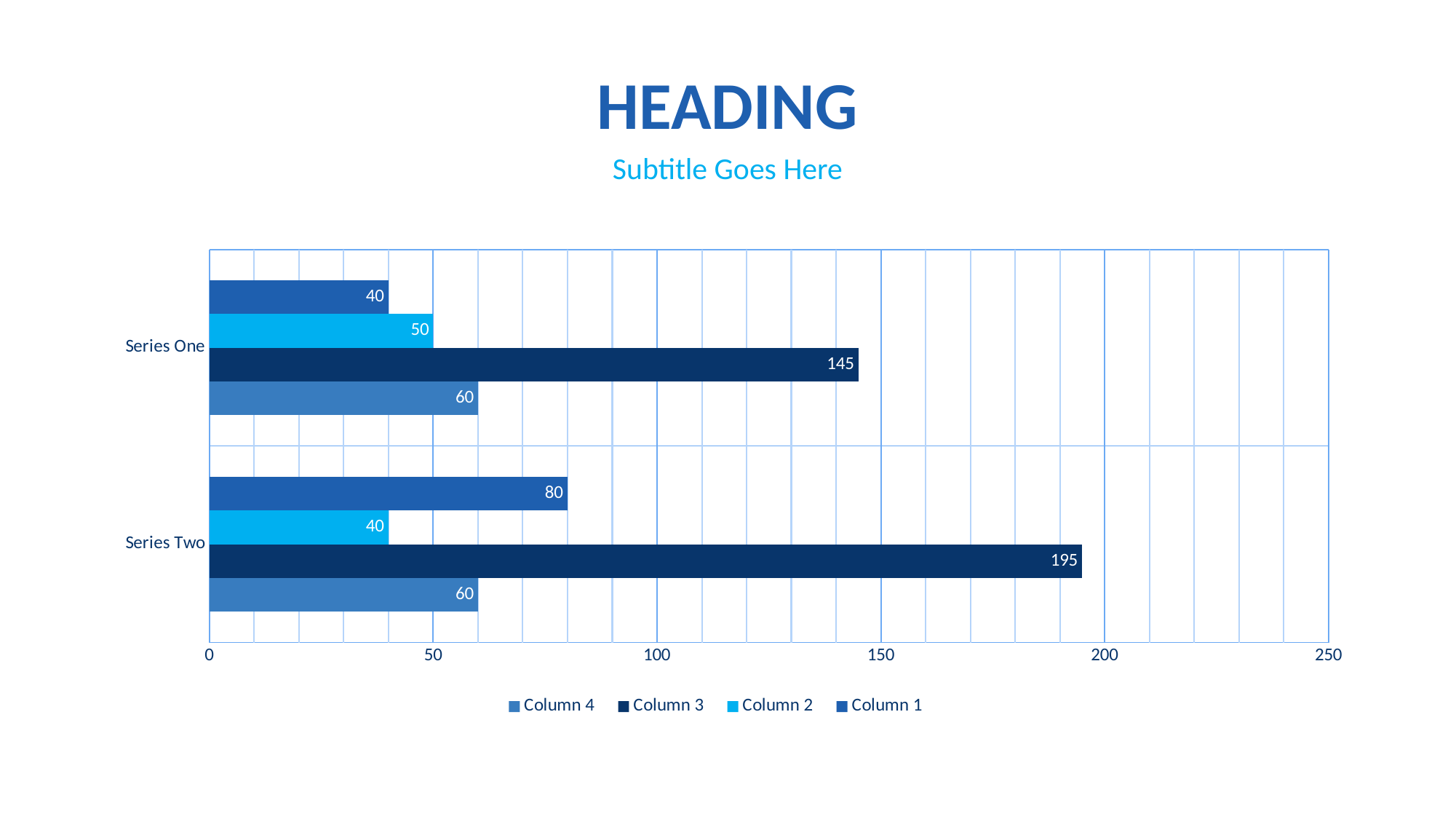
What kind of chart is shown on the slide? Bar chart What is the value of Column 3 for Series Two? 195 What is the value of Column 3 for Series One? 145 What is the total of the four values for Series One? 295 Which is larger: Column 1 for Series Two or Column 2 for Series Two? Column 1 for Series Two Which series has the highest value for Series Two? Column 3 What is the value of Column 2 for Series One? 50 How many categories are shown on the chart? 2 Which series has the lowest value for Series One? Column 1 How many series does the legend list? 4 What is the value of Column 1 for Series Two? 80 What is the difference between the Column 3 values for Series Two and Series One? 50